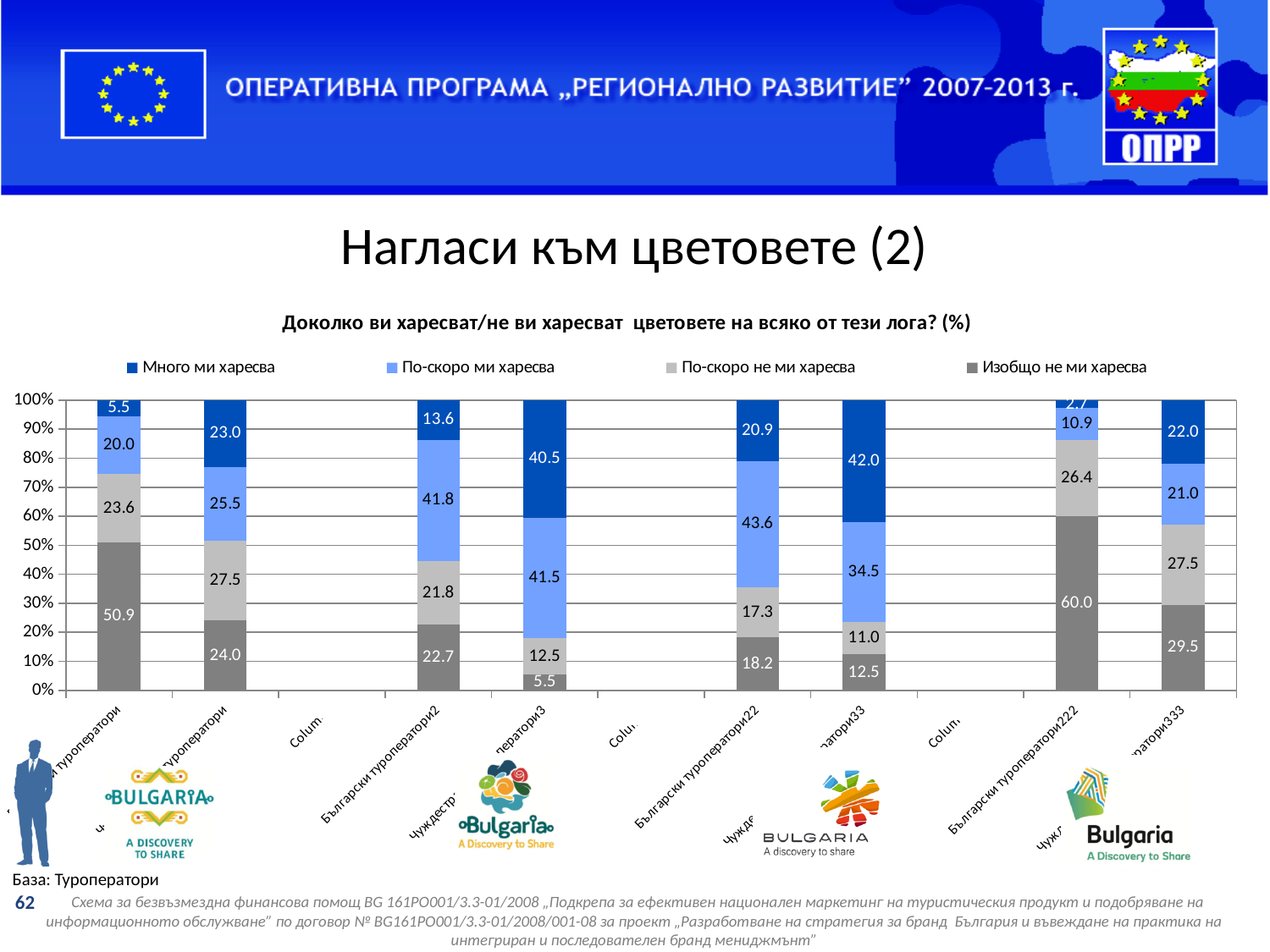
What is the title of the chart? Доколко ви харесват/не ви харесват цветовете на всяко от тези лога? (%) What is the difference between the "Много ми харесва" values for Български туроператори22 and Български туроператори2? 7.3 What is the value of "Много ми харесва" for Български туроператори2? 13.6 Which has the larger "Изобщо не ми харесва" value, Български туроператори222 or Български туроператори22? Български туроператори222 What kind of chart is shown on the slide? Stacked bar chart Among Български туроператори2, Български туроператори22 and Български туроператори222, which has the highest "Изобщо не ми харесва" value? Български туроператори222 What is the value of "Изобщо не ми харесва" for Български туроператори222? 60.0 What is the value of "По-скоро ми харесва" for Български туроператори222? 10.9 How many series does the legend list? 4 What is the value of "По-скоро не ми харесва" for Български туроператори2? 21.8 What is the value of "По-скоро ми харесва" for Български туроператори22? 43.6 What is the first entry in the chart legend? Много ми харесва